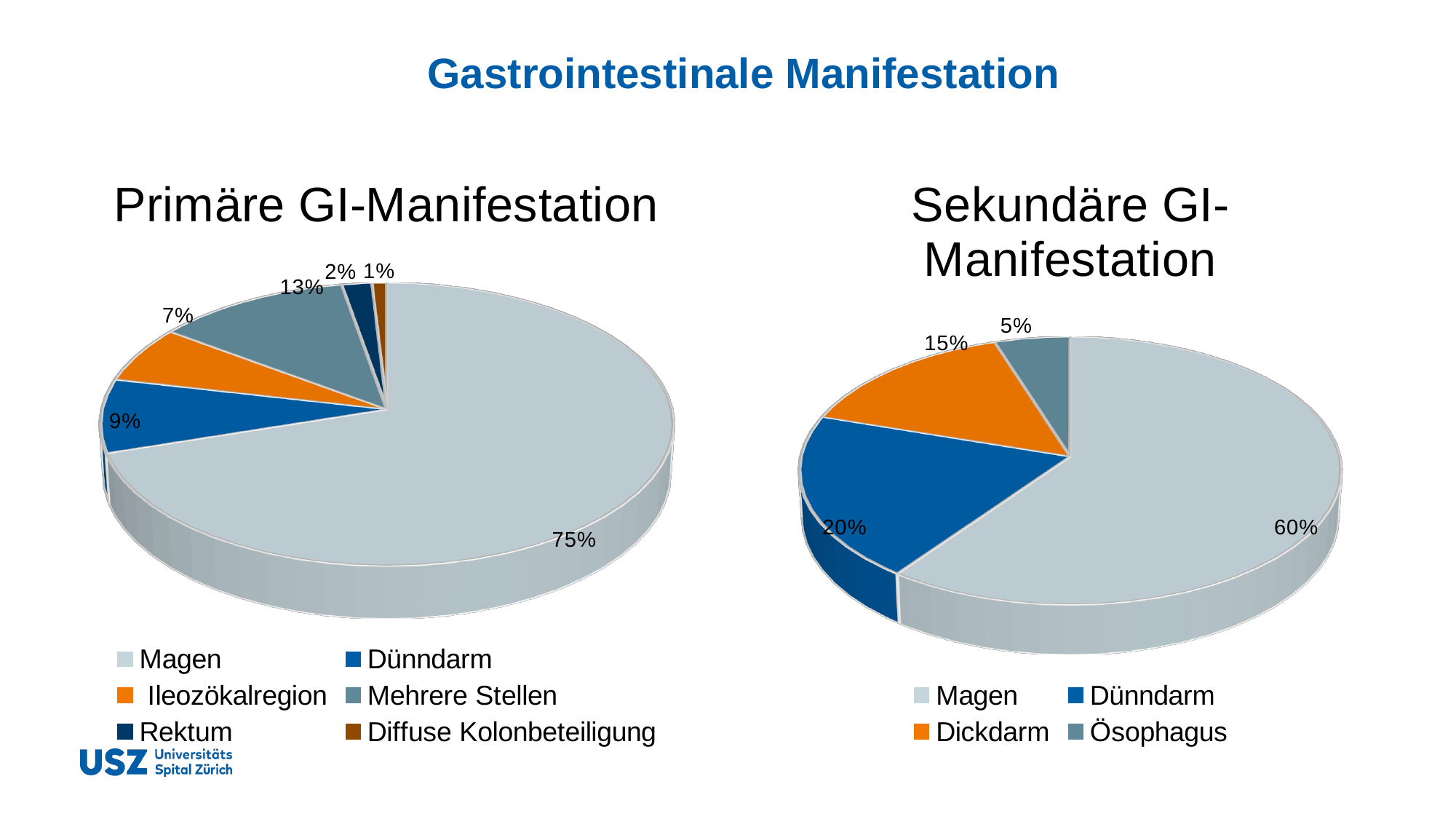
In the 'Sekundäre GI-Manifestation' chart, which category has the largest share? Magen In the 'Primäre GI-Manifestation' chart, which category has the smallest share? Diffuse Kolonbeteiligung In the 'Primäre GI-Manifestation' chart, how many categories are shown? 6 In the 'Sekundäre GI-Manifestation' chart, what share does Ösophagus have? 5% In the 'Primäre GI-Manifestation' chart, what share does Magen have? 75% In the 'Primäre GI-Manifestation' chart, what is the difference between the shares of Dünndarm and Rektum? 7% In the 'Sekundäre GI-Manifestation' chart, how many categories are shown? 4 In the 'Sekundäre GI-Manifestation' chart, which is larger, Dickdarm or Dünndarm? Dünndarm In the 'Sekundäre GI-Manifestation' chart, what share does Dünndarm have? 20% In the 'Primäre GI-Manifestation' chart, what share does Mehrere Stellen have? 13% In the 'Primäre GI-Manifestation' chart, what share does Ileozökalregion have? 7% What type of chart is used for 'Primäre GI-Manifestation'? Pie chart